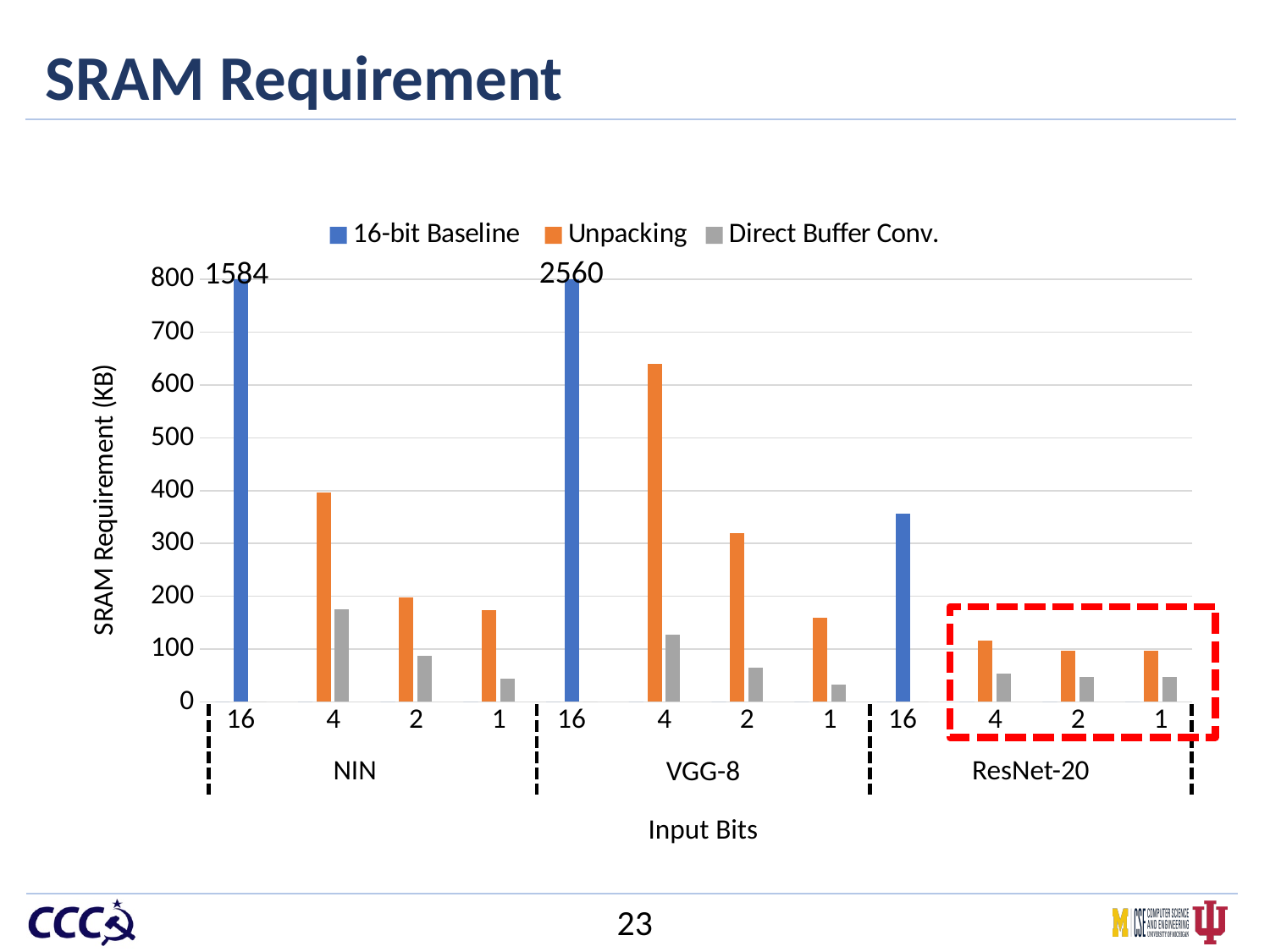
What is the title of the y axis? SRAM Requirement (KB) Is the 16-bit Baseline value for ResNet-20 greater or less than 300? greater What is the 16-bit Baseline SRAM requirement for VGG-8? 2560 Which network group is highlighted with a red dashed box? ResNet-20 Is the Direct Buffer Conv. value for NIN at 4 input bits greater or less than 200? less How many network groups are shown along the x axis? 3 Which has the larger 16-bit Baseline SRAM requirement, NIN or VGG-8? VGG-8 What is the 16-bit Baseline SRAM requirement for NIN? 1584 What kind of chart is shown on the slide? bar chart Within the NIN group, do the Unpacking bars rise or fall as input bits go from 4 to 1? fall Is the Unpacking value for VGG-8 at 4 input bits greater or less than 600? greater How many series does the legend list? 3